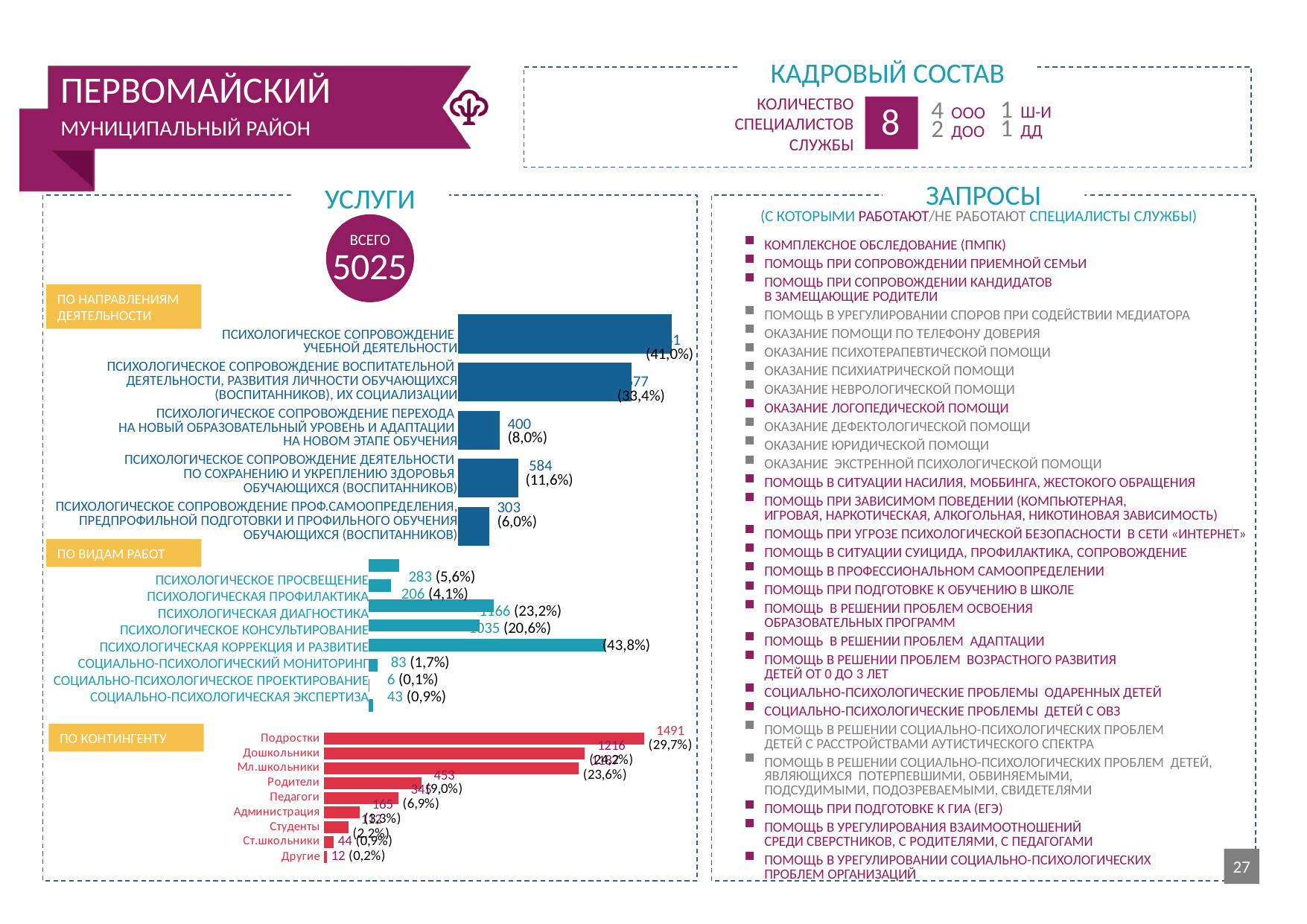
What type of chart is used in the 'По видам работ' section? Bar chart In the 'По контингенту' chart, what is the value for Другие? 12 (0,2%) In the 'По видам работ' chart, which category has the largest share? Психологическая коррекция и развитие How many categories are shown in the 'По контингенту' chart? 9 In the 'По видам работ' chart, which category has the lowest value? Социально-психологическое проектирование In the 'По контингенту' chart, what is the value for Подростки? 1491 (29,7%) In the 'По видам работ' chart, what is the value for Психологическая диагностика? 1166 (23,2%) In the 'По контингенту' chart, which category has the highest value? Подростки In the 'По контингенту' chart, which is larger: Родители or Администрация? Родители In the 'По направлениям деятельности' chart, what is the value for психологическое сопровождение деятельности по сохранению и укреплению здоровья обучающихся? 584 (11,6%) In the 'По видам работ' chart, what is the value for Социально-психологическое проектирование? 6 (0,1%) In the 'По видам работ' chart, what is the difference between Психологическая диагностика and Психологическое консультирование? 131